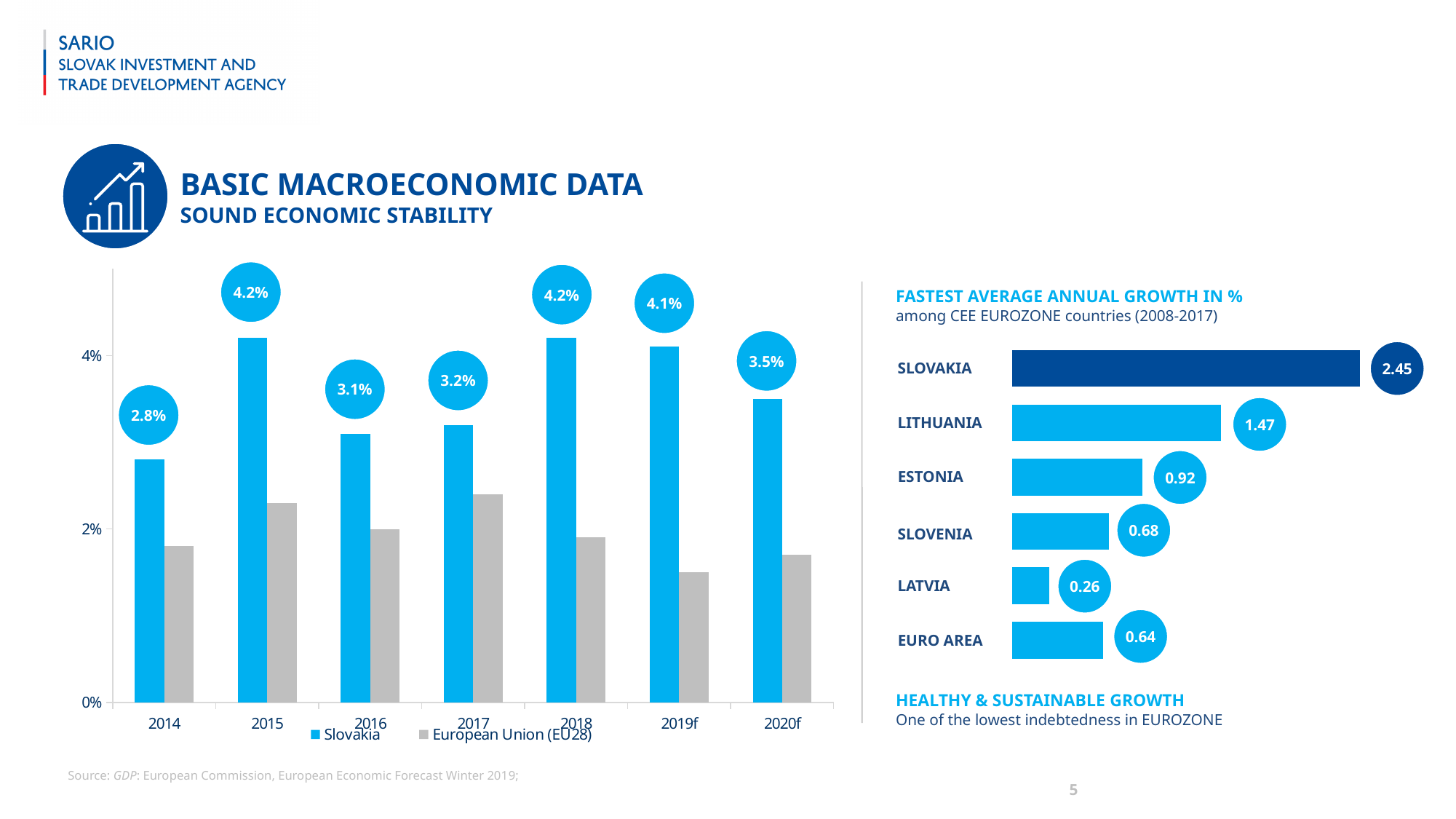
In the left bar chart, what is the value for Slovakia in 2020f? 3.5% In the left bar chart, what is the value for Slovakia in 2015? 4.2% In the left bar chart, how many series does the legend list? 2 In the left bar chart, how many years are shown on the x axis? 7 In the left bar chart, what is the difference between the Slovakia values for 2019f and 2014? 1.3% In the chart titled 'Fastest average annual growth in %', which is larger, Slovenia or Euro Area? Slovenia In the chart titled 'Fastest average annual growth in %', which country has the lowest value? Latvia In the left bar chart, which year has the lowest value for Slovakia? 2014 What kind of chart is the chart titled 'Fastest average annual growth in %'? bar chart In the left bar chart, is the value for European Union (EU28) in 2019f greater or less than 2%? less In the chart titled 'Fastest average annual growth in %', what is the difference between Slovakia and Estonia? 1.53 In the chart titled 'Fastest average annual growth in %', what is the value for Lithuania? 1.47